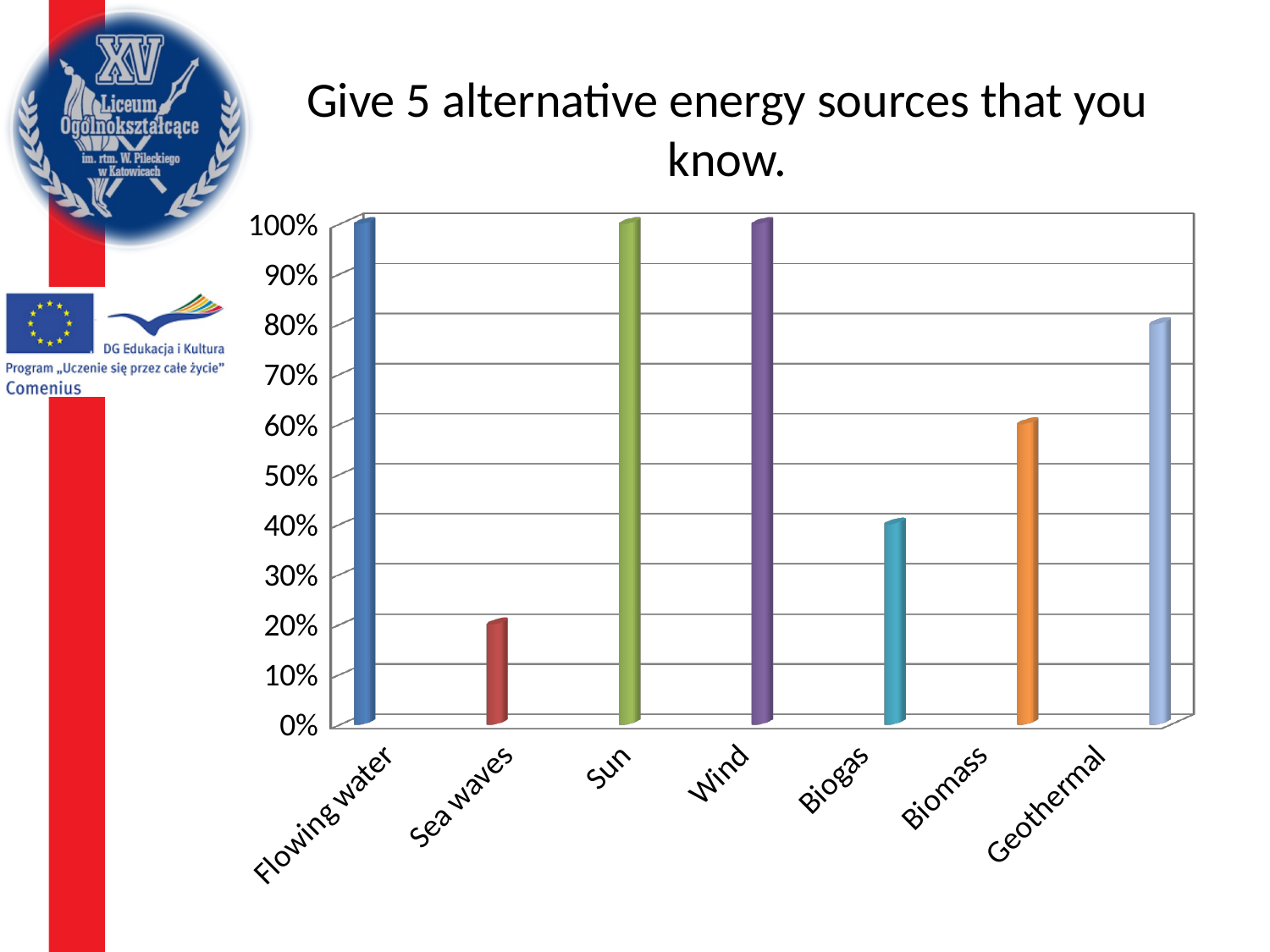
What is the value for Biomass? 60% How many energy source categories are shown on the x axis? 7 What is the value for Wind? 100% What is the value for Sea waves? 20% What kind of chart is shown on the slide? bar chart What is the title of the chart? Give 5 alternative energy sources that you know. What is the difference between the values for Geothermal and Biomass? 20% Which energy source has the lowest value? Sea waves Is the value for Geothermal greater or less than 50%? greater What is the value for Biogas? 40% What is the value for Geothermal? 80% Which is larger, the value for Biomass or the value for Biogas? Biomass